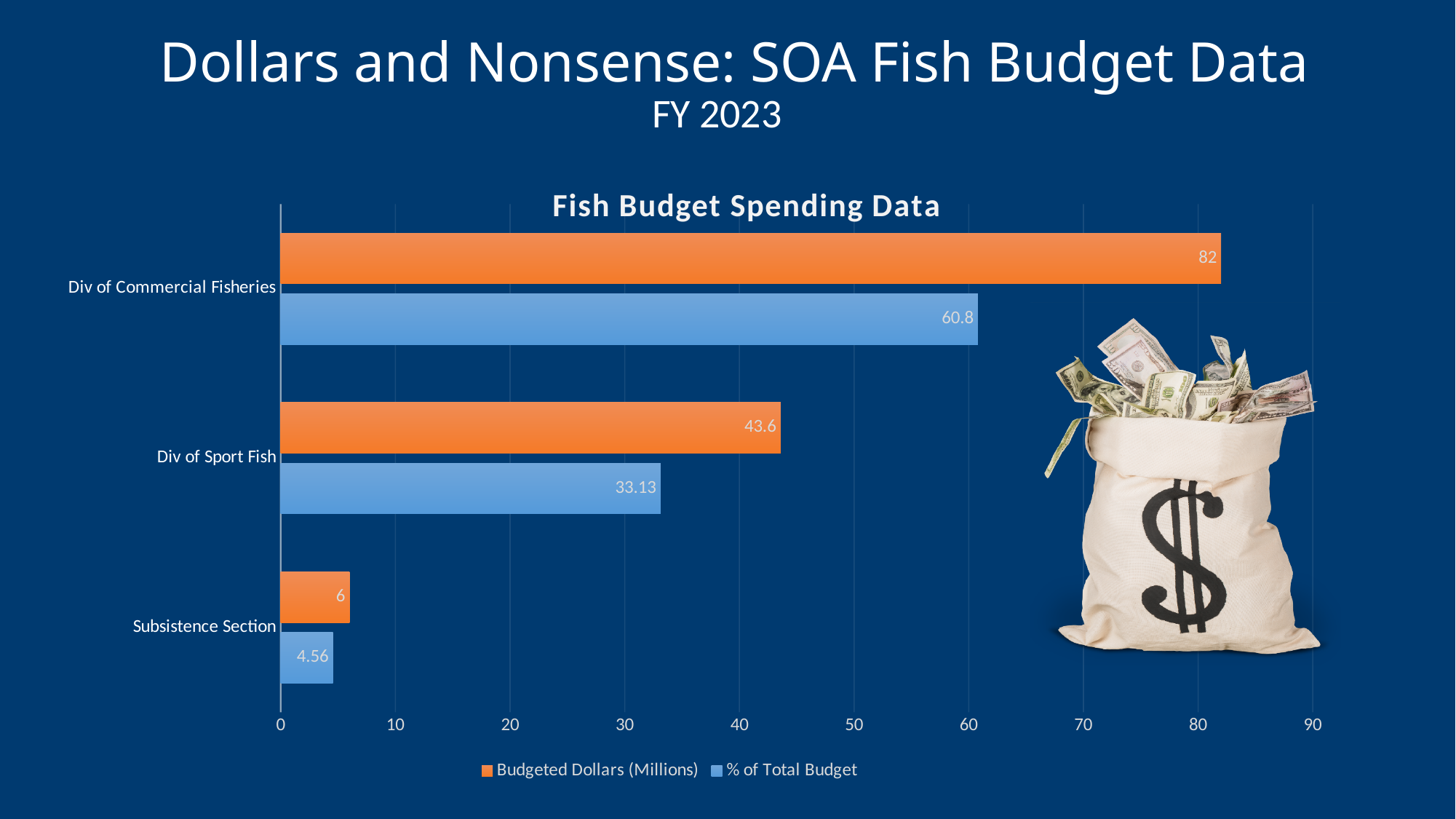
What is the % of Total Budget value for Subsistence Section? 4.56 Which category has the highest Budgeted Dollars (Millions) value? Div of Commercial Fisheries Which category has the lowest % of Total Budget value? Subsistence Section Which is larger: the % of Total Budget for Div of Commercial Fisheries or the Budgeted Dollars (Millions) for Div of Sport Fish? % of Total Budget for Div of Commercial Fisheries What is the Budgeted Dollars (Millions) value for Div of Sport Fish? 43.6 How many categories are shown on the chart? 3 What is the Budgeted Dollars (Millions) value for Div of Commercial Fisheries? 82 What kind of chart is shown on the slide? Bar chart What is the title of the chart? Fish Budget Spending Data How many series does the legend list? 2 What is the % of Total Budget value for Div of Sport Fish? 33.13 What is the difference between the Budgeted Dollars (Millions) values for Div of Commercial Fisheries and Div of Sport Fish? 38.4